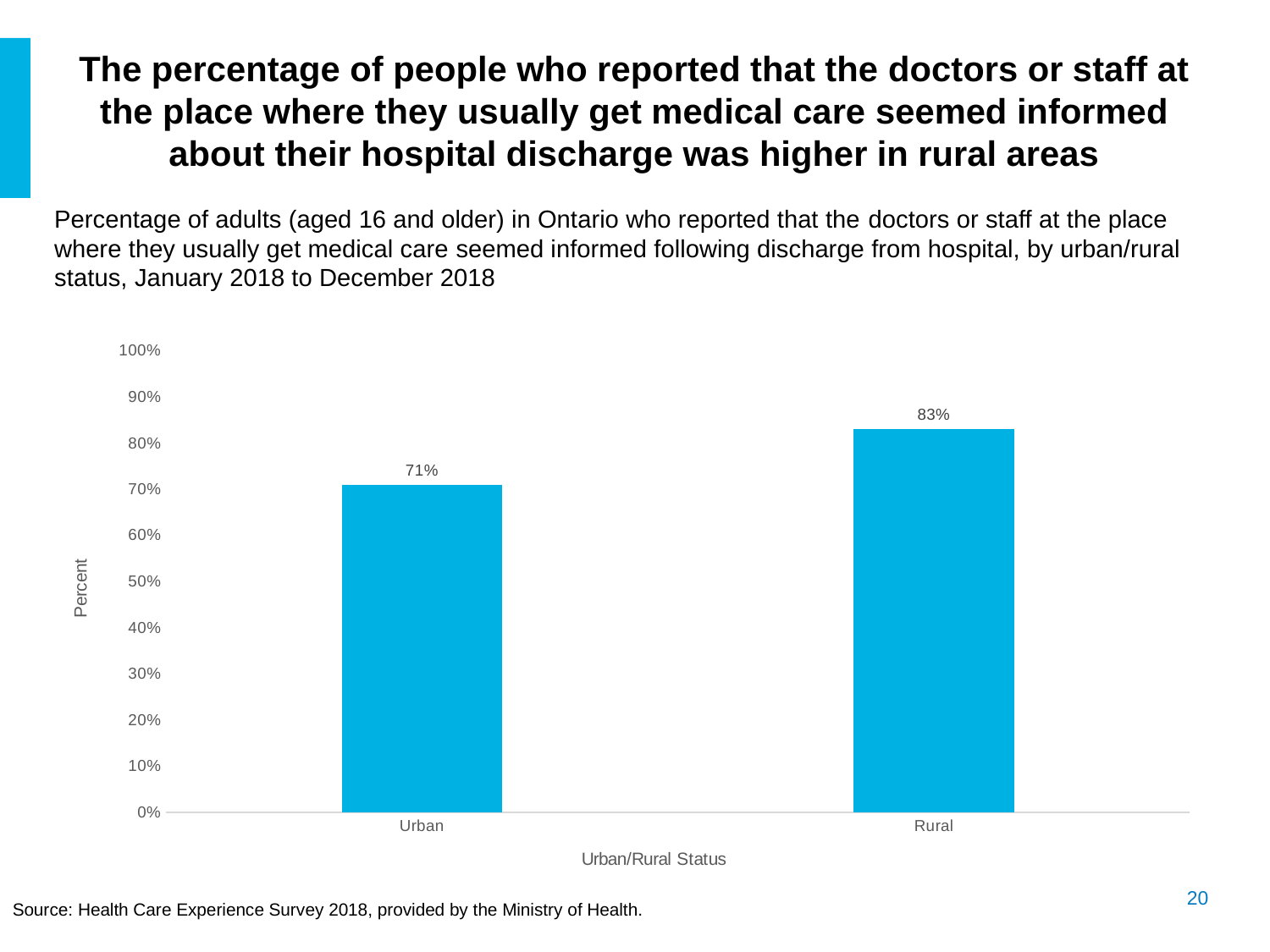
What is the difference between the Rural and Urban values? 12% Which category has the lower value? Urban What percentage is shown for Rural? 83% What is the label of the y axis? Percent Is the value for Urban greater or less than 80%? less Which category has the higher value? Rural Is the value for Rural larger or smaller than the value for Urban? larger Is the value for Rural greater or less than 80%? greater How many categories are shown on the x axis? 2 What kind of chart is shown? bar chart What percentage is shown for Urban? 71% What is the label of the x axis? Urban/Rural Status